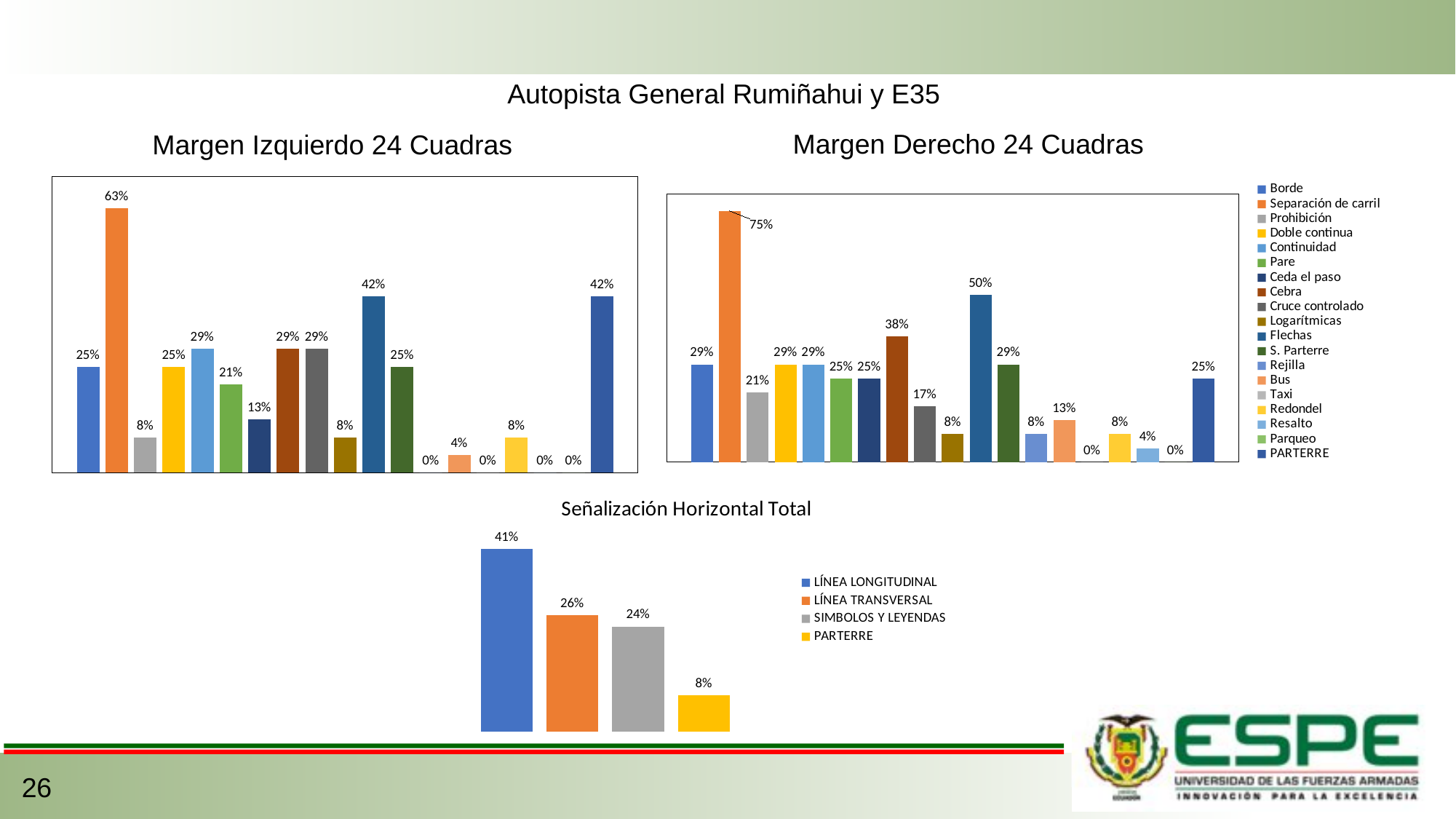
In the Margen Derecho 24 Cuadras chart, which series has the highest value? Separación de carril In the Margen Derecho 24 Cuadras chart, what is the difference between Cebra and Cruce controlado? 21% In the Margen Izquierdo 24 Cuadras chart, what is the value for Separación de carril? 63% In the Margen Derecho 24 Cuadras chart, what is the value for Flechas? 50% In the Señalización Horizontal Total chart, do the values rise or fall from left to right? Fall In the Señalización Horizontal Total chart, which category has the lowest value? PARTERRE In the Señalización Horizontal Total chart, what is the difference between LÍNEA LONGITUDINAL and LÍNEA TRANSVERSAL? 15% In the Margen Izquierdo 24 Cuadras chart, which is larger, Flechas or Cebra? Flechas How many series does the legend of the Margen Derecho 24 Cuadras chart list? 19 What kind of chart is the Señalización Horizontal Total chart? Bar chart In the Margen Derecho 24 Cuadras chart, which is larger, Prohibición or Bus? Prohibición How many categories are shown in the Señalización Horizontal Total chart? 4